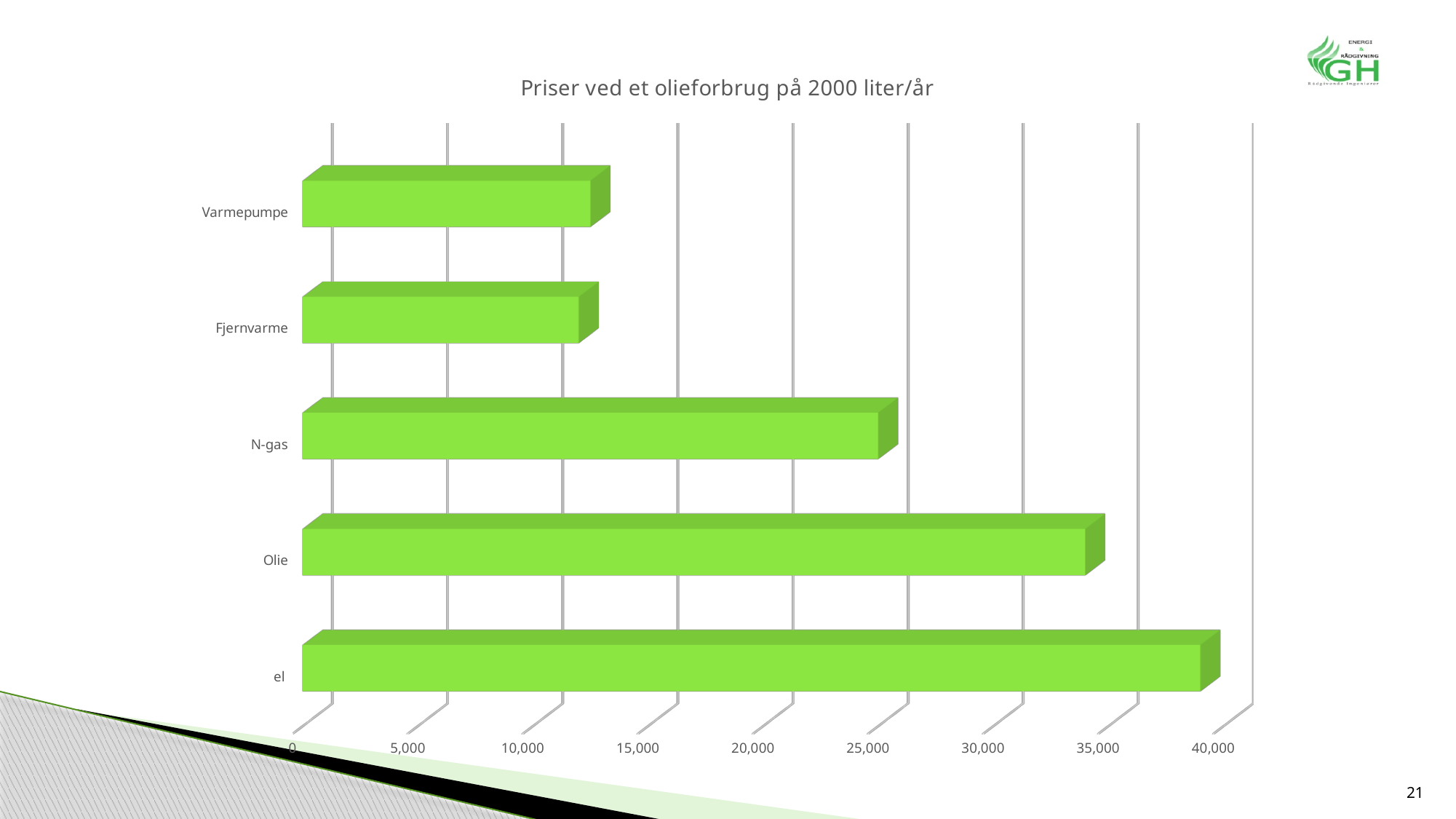
Which category has the highest value? el Is the value for Fjernvarme greater or less than 15,000? less What is the highest value shown on the horizontal axis? 40,000 Which is larger, the value for Olie or the value for N-gas? Olie Is the value for el greater or less than 35,000? greater What kind of chart is shown on the slide? bar chart Is the value for N-gas greater or less than 20,000? greater Which is larger, the value for N-gas or the value for Varmepumpe? N-gas What is the title of the chart? Priser ved et olieforbrug på 2000 liter/år How many categories are plotted in the chart? 5